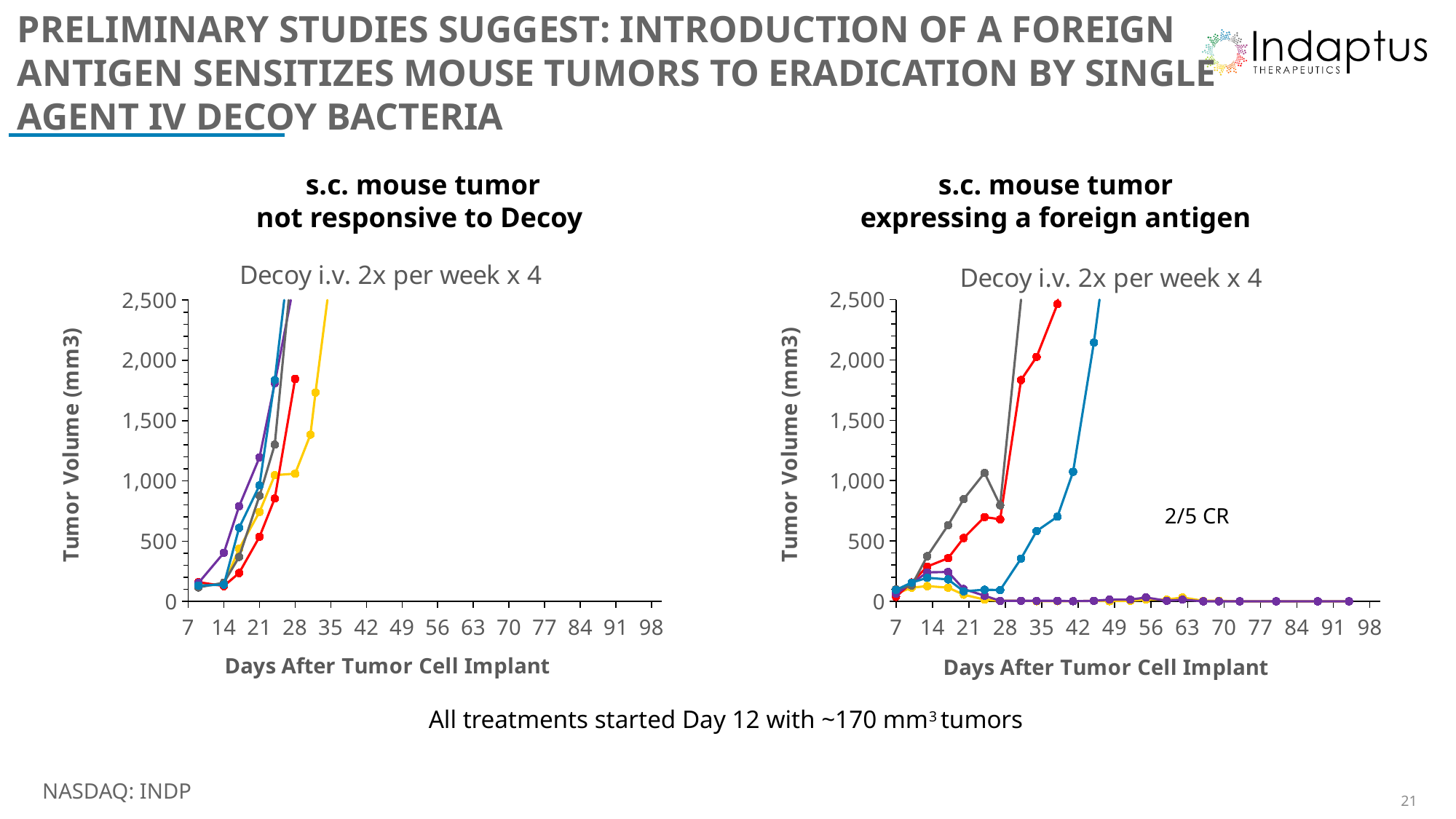
In the left chart ('not responsive to Decoy'), do the tumor volume lines rise or fall as days increase? rise What kind of chart is the left chart titled 's.c. mouse tumor not responsive to Decoy'? line chart In the right chart ('expressing a foreign antigen'), does the purple line rise or fall after day 21? fall In the right chart ('expressing a foreign antigen'), is the value of the purple line at day 91 greater or less than 500? less In the left chart ('not responsive to Decoy'), is the value of the red line at day 28 greater or less than 1,500? greater What is the x-axis label on the left chart? Days After Tumor Cell Implant In the left chart ('not responsive to Decoy'), is the value of the yellow line at day 21 greater or less than 1,000? less In the right chart ('expressing a foreign antigen'), at day 14, is the gray line or the yellow line higher? gray line What is the y-axis label on the right chart titled 's.c. mouse tumor expressing a foreign antigen'? Tumor Volume (mm3)